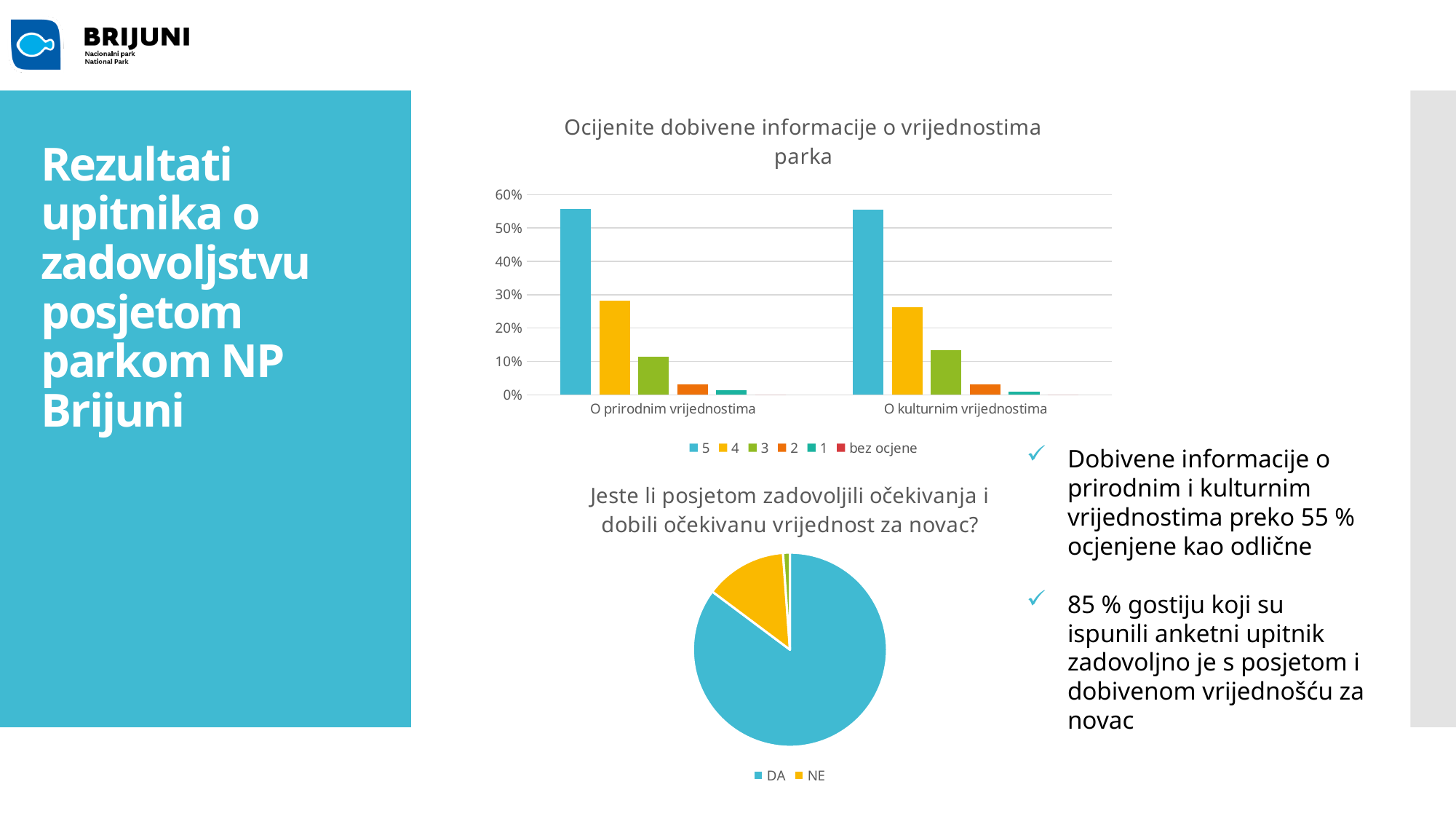
In the bottom pie chart, how many entries does the legend list? 2 In the top bar chart, is the value for rating 4 under "O kulturnim vrijednostima" greater or less than 30%? less What kind of chart is the top chart titled "Ocijenite dobivene informacije o vrijednostima parka"? bar chart In the top bar chart, how many categories are shown on the x axis? 2 In the bottom pie chart, which legend entry has the largest slice? DA In the top bar chart, which is larger for "O kulturnim vrijednostima": the value for rating 4 or the value for rating 3? rating 4 What kind of chart is the bottom chart titled "Jeste li posjetom zadovoljili očekivanja i dobili očekivanu vrijednost za novac?"? pie chart In the top bar chart, how many series does the legend list? 6 In the top bar chart, is the value for rating 3 under "O prirodnim vrijednostima" greater or less than 20%? less In the top bar chart, which rating series has the highest value for "O prirodnim vrijednostima"? 5 In the top bar chart, which rating series has the highest value for "O kulturnim vrijednostima"? 5 In the top bar chart, is the value for rating 5 under "O prirodnim vrijednostima" greater or less than 50%? greater